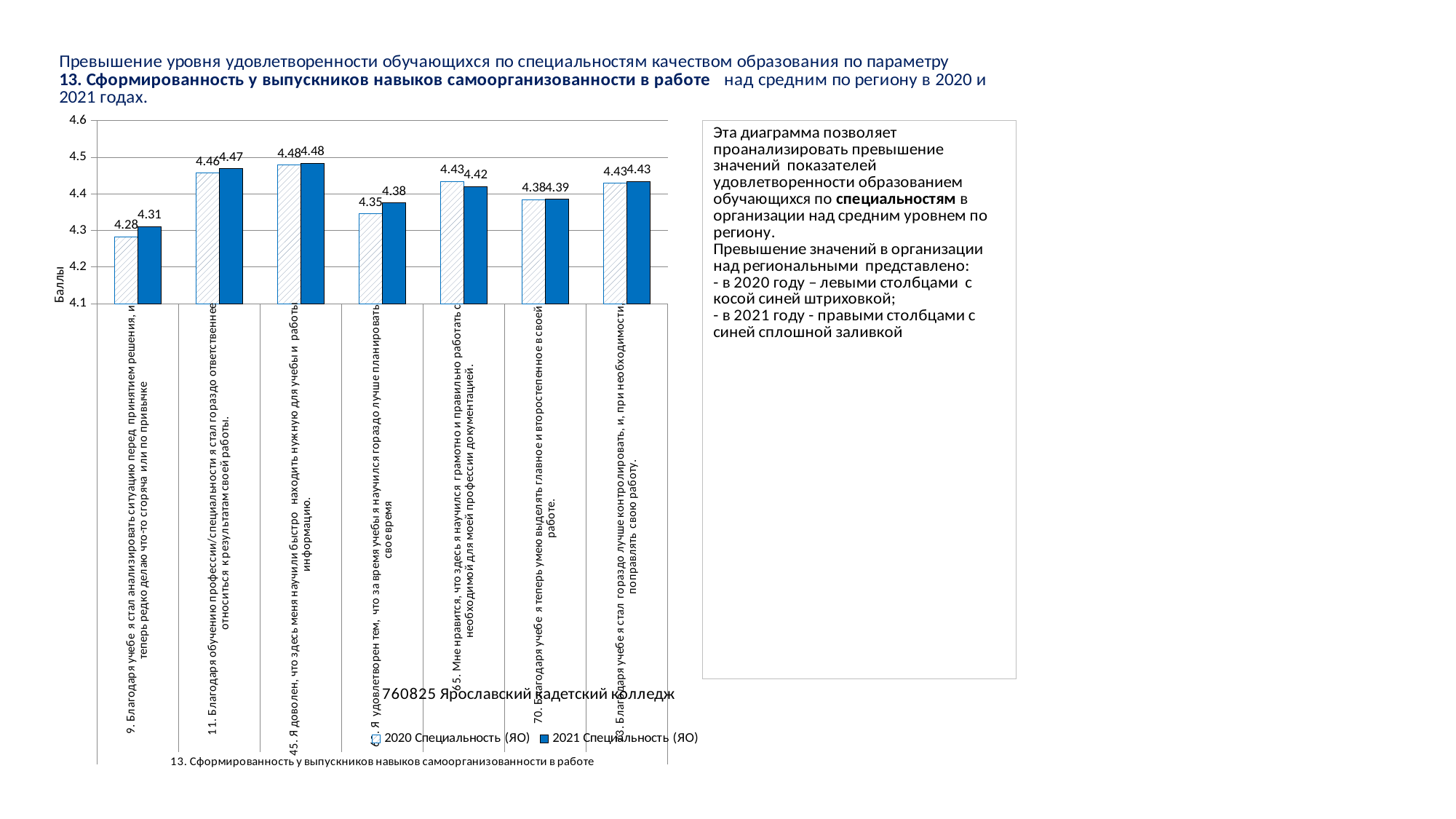
What is the 2020 Специальность (ЯО) value for statement 65 (Мне нравится, что здесь я научился грамотно и правильно работать с необходимой для моей профессии документацией)? 4.43 Which statement has the lowest 2021 Специальность (ЯО) value? 9. Благодаря учебе я стал анализировать ситуацию перед принятием решения, и теперь редко делаю что-то сгоряча или по привычке How many series does the chart legend list? 2 What is the 2020 Специальность (ЯО) value for statement 9 (Благодаря учебе я стал анализировать ситуацию перед принятием решения)? 4.28 For statement 65, which is larger: the 2020 Специальность (ЯО) value or the 2021 Специальность (ЯО) value? 2020 Специальность (ЯО) What is the 2021 Специальность (ЯО) value for statement 9 (Благодаря учебе я стал анализировать ситуацию перед принятием решения)? 4.31 What is the 2021 Специальность (ЯО) value for statement 11 (Благодаря обучению профессии/специальности я стал гораздо ответственнее относиться к результатам своей работы)? 4.47 What type of chart is shown on the slide? bar chart How many categories (statements) are plotted on the x axis of the chart? 7 Which series is shown with solid blue fill in the chart? 2021 Специальность (ЯО) What is the difference between the 2021 and 2020 Специальность (ЯО) values for statement 9? 0.03 Which statement has the highest 2020 Специальность (ЯО) value? 45. Я доволен, что здесь меня научили быстро находить нужную для учебы и работы информацию